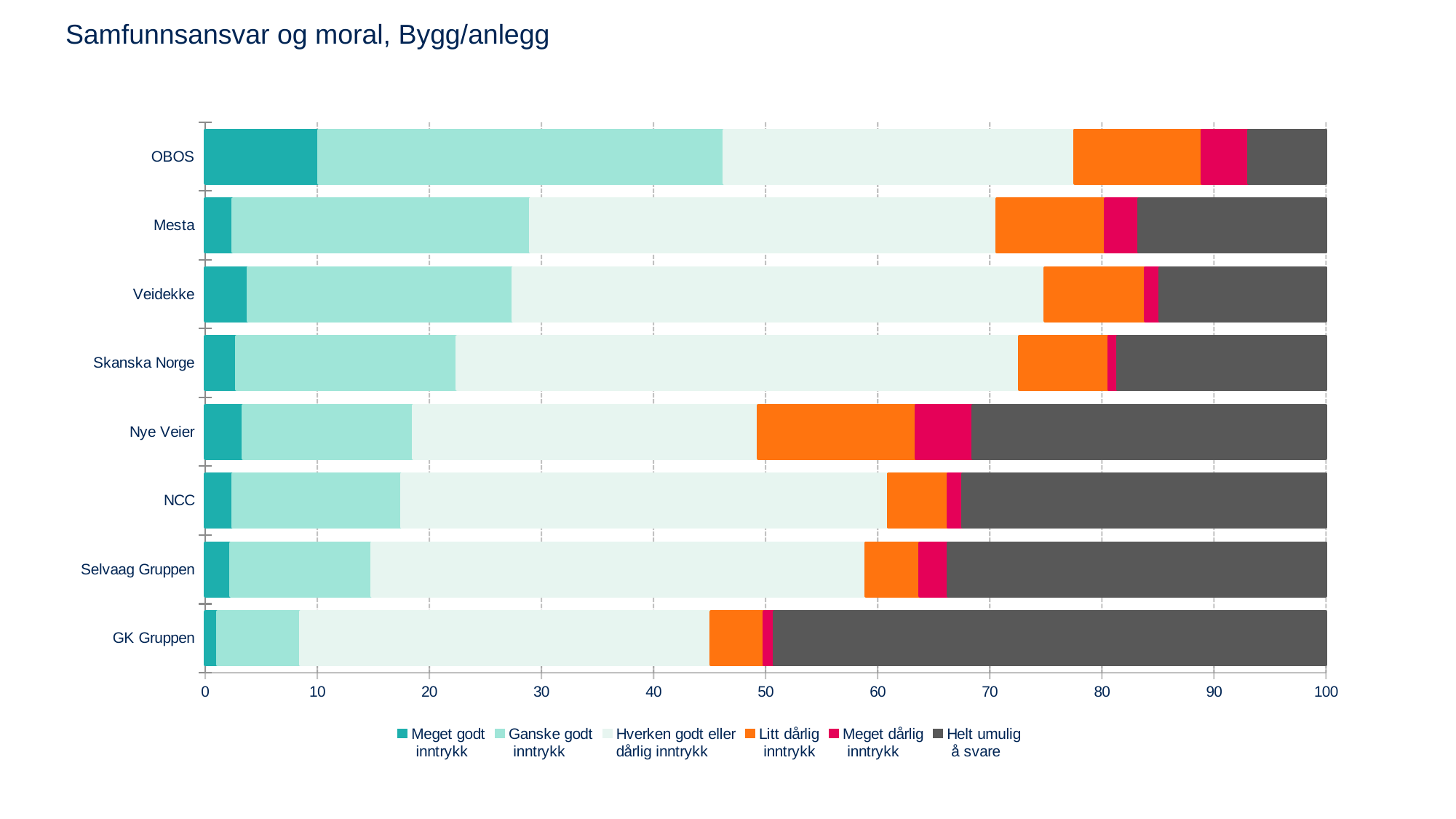
Which company has the largest 'Helt umulig å svare' segment? GK Gruppen Which company has the smallest 'Helt umulig å svare' segment? OBOS Which has a larger 'Litt dårlig inntrykk' segment, Nye Veier or NCC? Nye Veier Is the 'Meget godt inntrykk' value for OBOS greater or less than 5? greater What kind of chart is shown on the slide? Stacked bar chart Which company has the largest 'Ganske godt inntrykk' segment? OBOS What is the title of the chart? Samfunnsansvar og moral, Bygg/anlegg Which company has the smallest 'Ganske godt inntrykk' segment? GK Gruppen Is the 'Helt umulig å svare' value for GK Gruppen greater or less than 40? greater How many series does the legend list? 6 How many companies are listed on the vertical axis of the chart? 8 Which has a larger 'Meget godt inntrykk' segment, OBOS or Mesta? OBOS